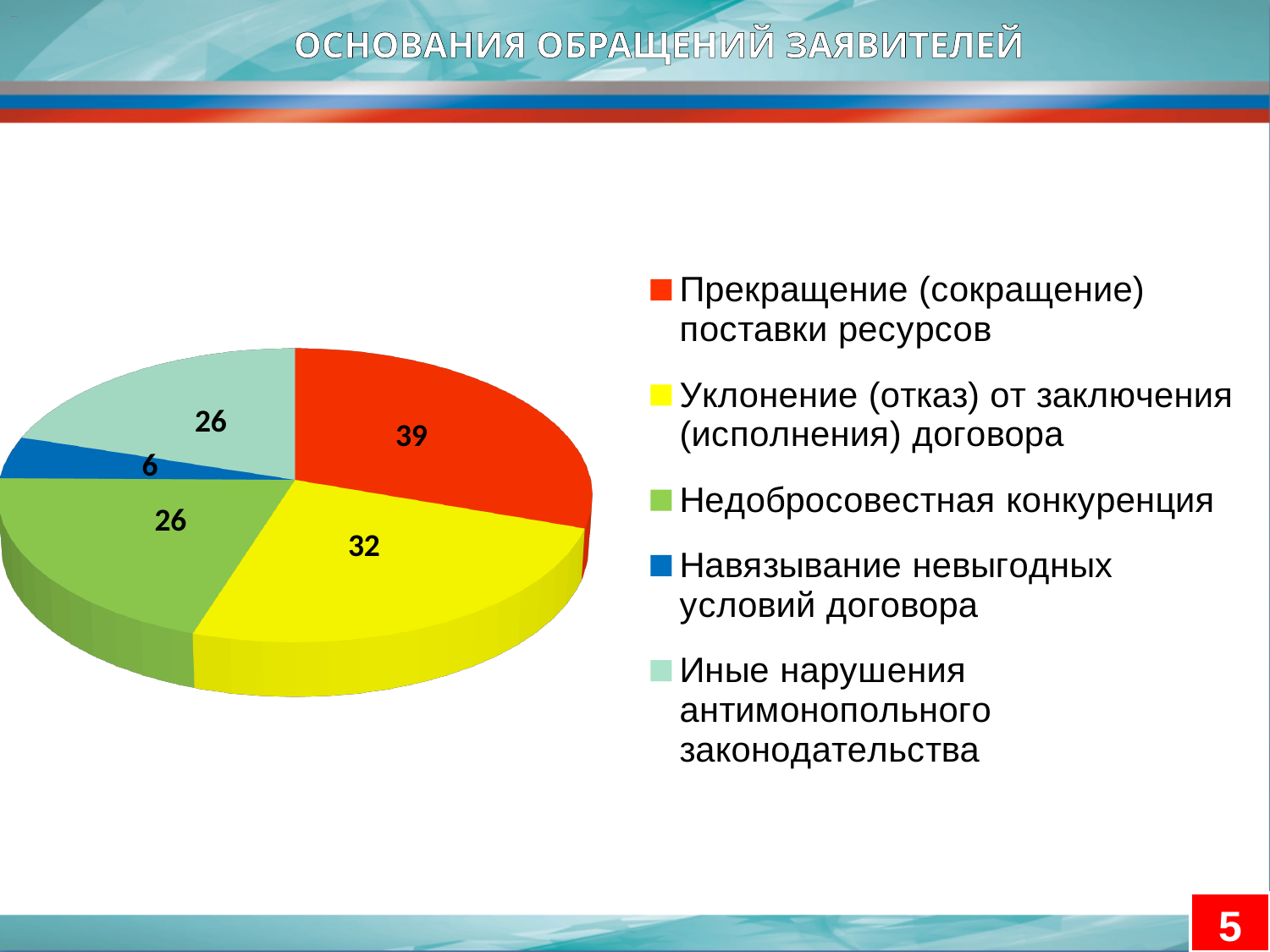
Which category has the largest slice of the pie? Прекращение (сокращение) поставки ресурсов What is the difference between the values for «Прекращение (сокращение) поставки ресурсов» and «Уклонение (отказ) от заключения (исполнения) договора»? 7 What is the total of all the values shown on the pie chart? 129 What colour is the slice for «Иные нарушения антимонопольного законодательства»? Light green What is the value for «Навязывание невыгодных условий договора»? 6 What is the value for «Прекращение (сокращение) поставки ресурсов»? 39 Which is larger: the value for «Недобросовестная конкуренция» or the value for «Навязывание невыгодных условий договора»? Недобросовестная конкуренция How many categories does the pie chart have? 5 What is the value for «Недобросовестная конкуренция»? 26 What is the value for «Уклонение (отказ) от заключения (исполнения) договора»? 32 Which category has the smallest slice of the pie? Навязывание невыгодных условий договора What type of chart is shown on the slide? Pie chart